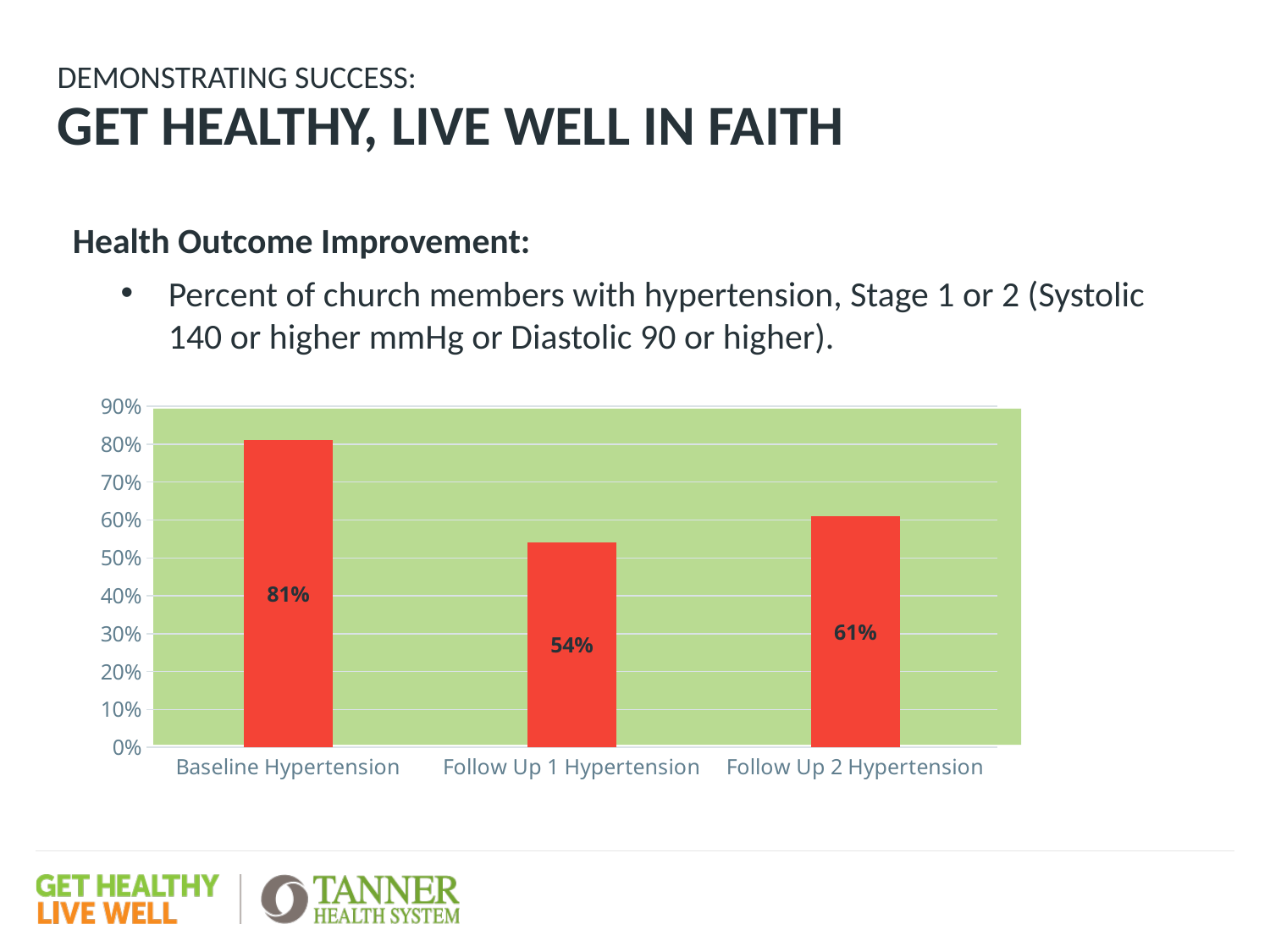
What is the value for Follow Up 1 Hypertension? 54% Which is larger, the value for Follow Up 1 Hypertension or Follow Up 2 Hypertension? Follow Up 2 Hypertension What is the difference between the Follow Up 2 Hypertension value and the Follow Up 1 Hypertension value? 7% How many categories are shown on the x axis? 3 Which category has the lowest value? Follow Up 1 Hypertension Is the value for Follow Up 2 Hypertension greater or less than 70%? less What is the value for Baseline Hypertension? 81% Which category has the highest value? Baseline Hypertension What is the difference between the Baseline Hypertension value and the Follow Up 1 Hypertension value? 27% What colour are the bars in the chart? red What kind of chart is shown on the slide? bar chart What is the value for Follow Up 2 Hypertension? 61%